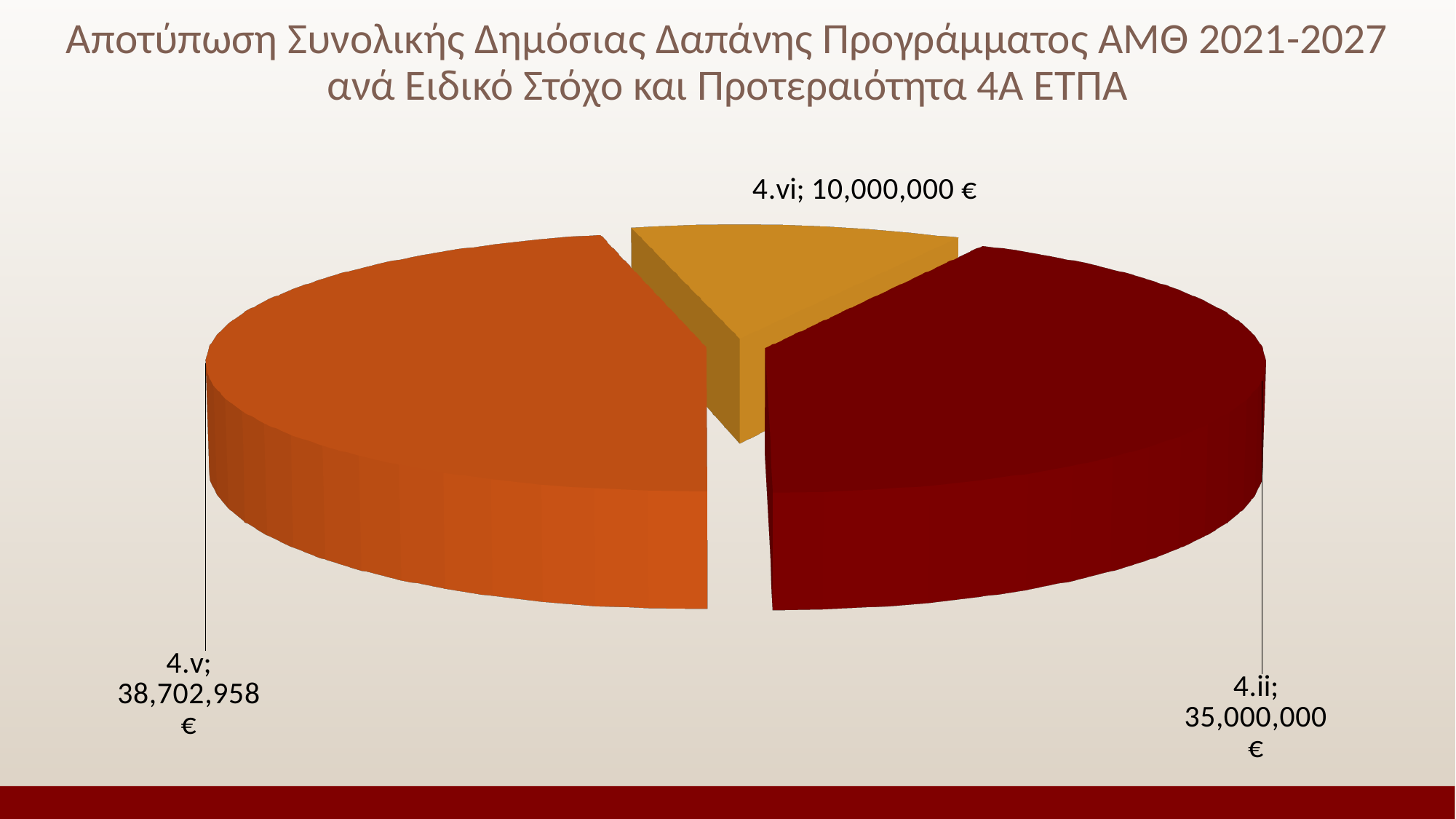
What is the difference between the values for 4.ii and 4.vi? 25,000,000 € What colour is the slice for 4.vi? Gold/yellow What kind of chart is shown on the slide? Pie chart What is the value shown for 4.vi? 10,000,000 € Which is larger, the value for 4.v or the value for 4.ii? 4.v What is the value shown for 4.v? 38,702,958 € What is the value shown for 4.ii? 35,000,000 € What is the total of all three slices in the pie chart? 83,702,958 € What is the difference between the values for 4.v and 4.ii? 3,702,958 € How many slices does the pie chart have? 3 Which category has the largest value in the pie chart? 4.v Which category has the smallest value in the pie chart? 4.vi